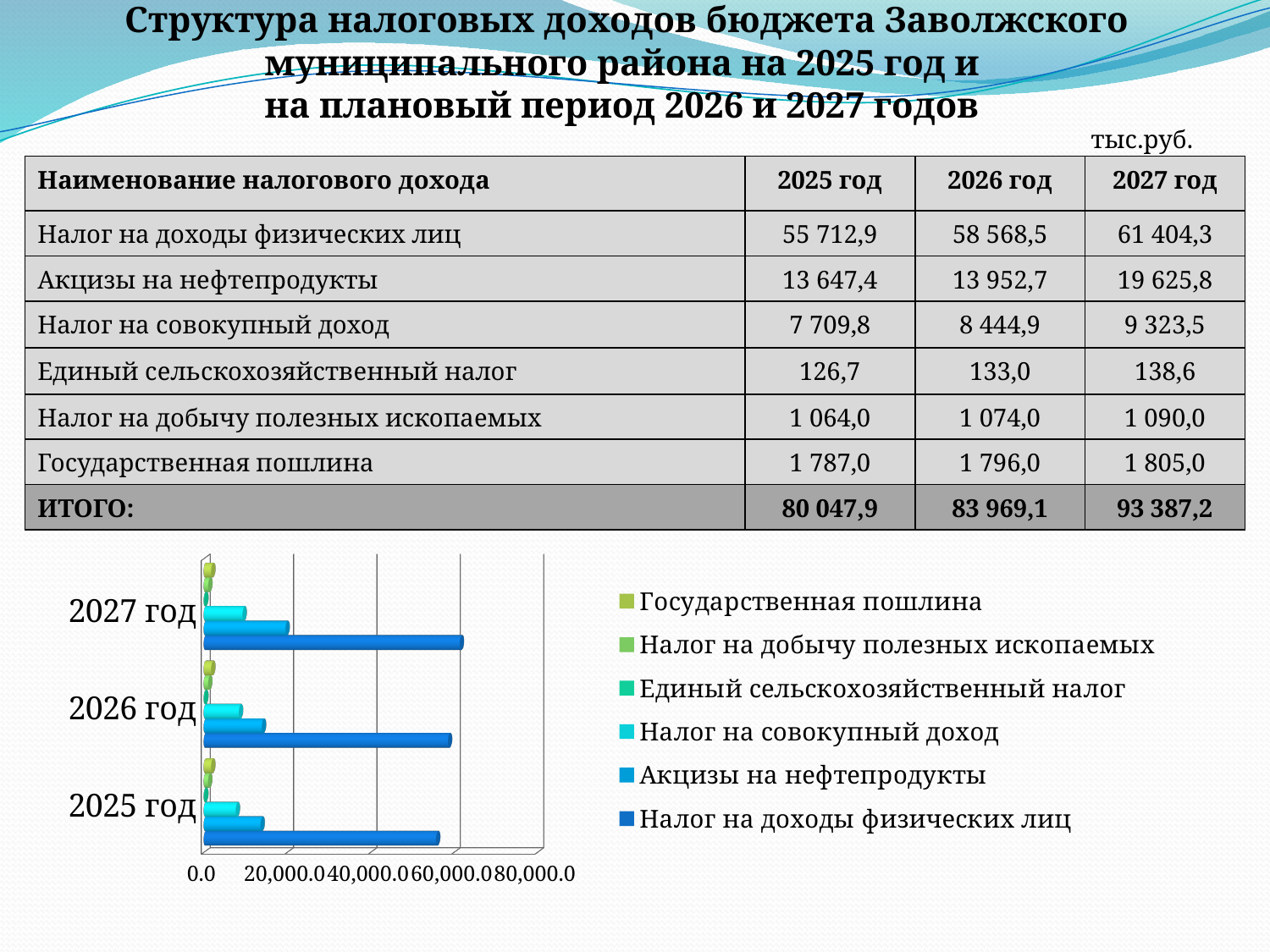
Is the bar for Акцизы на нефтепродукты in 2025 год greater or less than 20,000.0? less According to the table above the chart, what value is plotted for Налог на доходы физических лиц in 2027 год? 61 404,3 Which is larger in the chart: Акцизы на нефтепродукты for 2027 год or for 2025 год? 2027 год Which is larger in the chart: Налог на доходы физических лиц for 2027 год or for 2025 год? 2027 год Is the bar for Налог на доходы физических лиц in 2025 год greater or less than 60,000.0? less How many series does the chart legend list? 6 Which legend entry is shown in the darkest blue colour in the chart? Налог на доходы физических лиц Which series has the longest bar for 2025 год in the chart? Налог на доходы физических лиц How many year categories does the bar chart show? 3 What kind of chart is shown on the slide? bar chart Does the bar for Налог на доходы физических лиц rise or fall from 2025 год to 2027 год? rise Is the bar for Налог на совокупный доход in 2027 год greater or less than 20,000.0? less